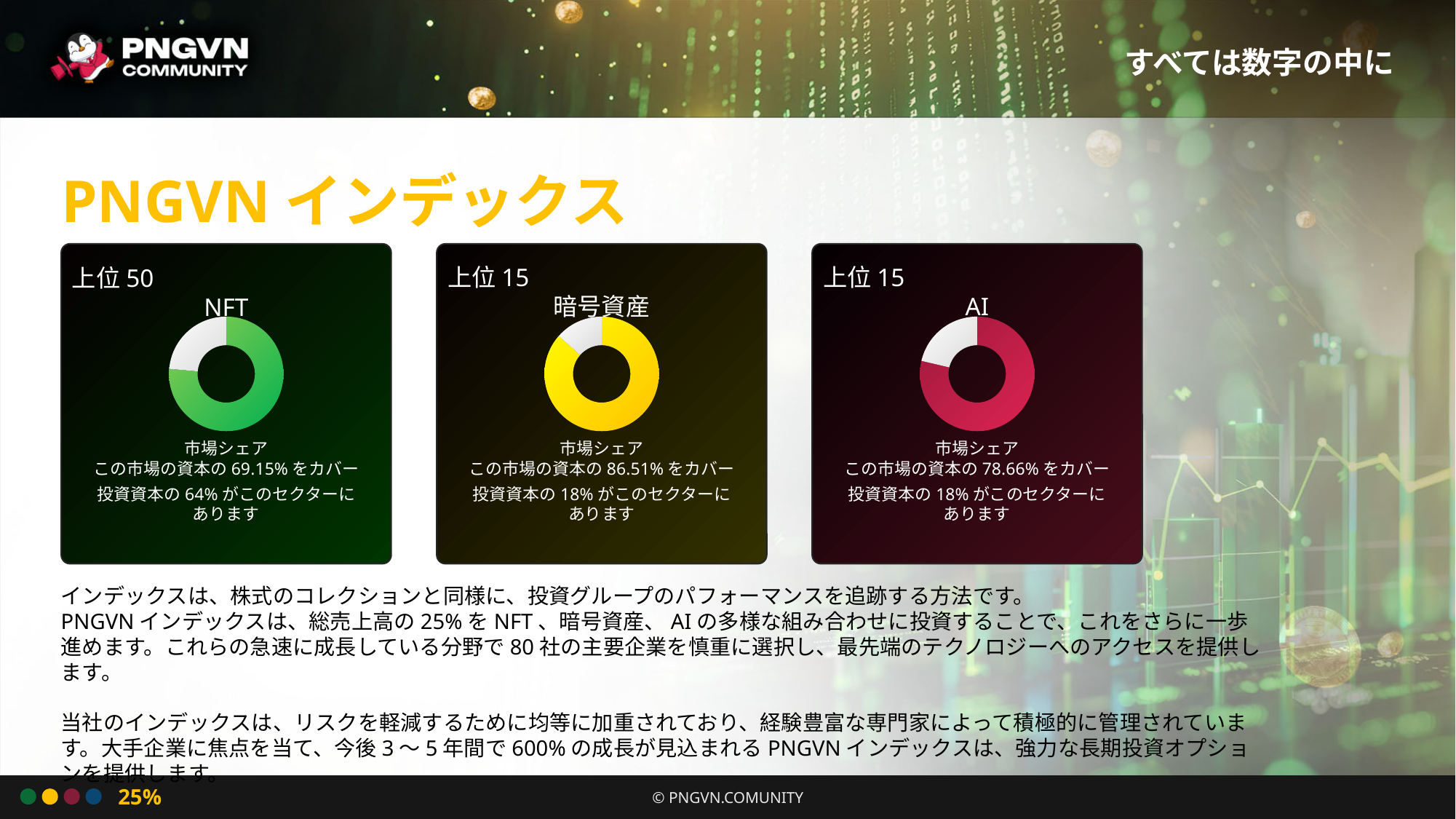
How many donut charts are shown on the slide? 3 What is the title of the donut chart in the middle panel? 暗号資産 Which of the three donut charts shows the lowest market coverage percentage? NFT Which of the three donut charts shows the highest market coverage percentage? 暗号資産 In the NFT chart, what percentage of the market's capital is covered? 69.15% Which is larger, the market coverage in the AI chart or in the NFT chart? AI What is the difference between the market coverage shown in the 暗号資産 chart and the NFT chart? 17.36% In the AI chart, what percentage of the market's capital is covered? 78.66% What kind of chart is used for the NFT, 暗号資産 and AI panels? Donut (pie) chart In the 暗号資産 chart, what percentage of the market's capital is covered? 86.51% What colour is the filled portion of the AI donut chart? Red (crimson) In the NFT chart, is the covered share greater or less than 50%? greater